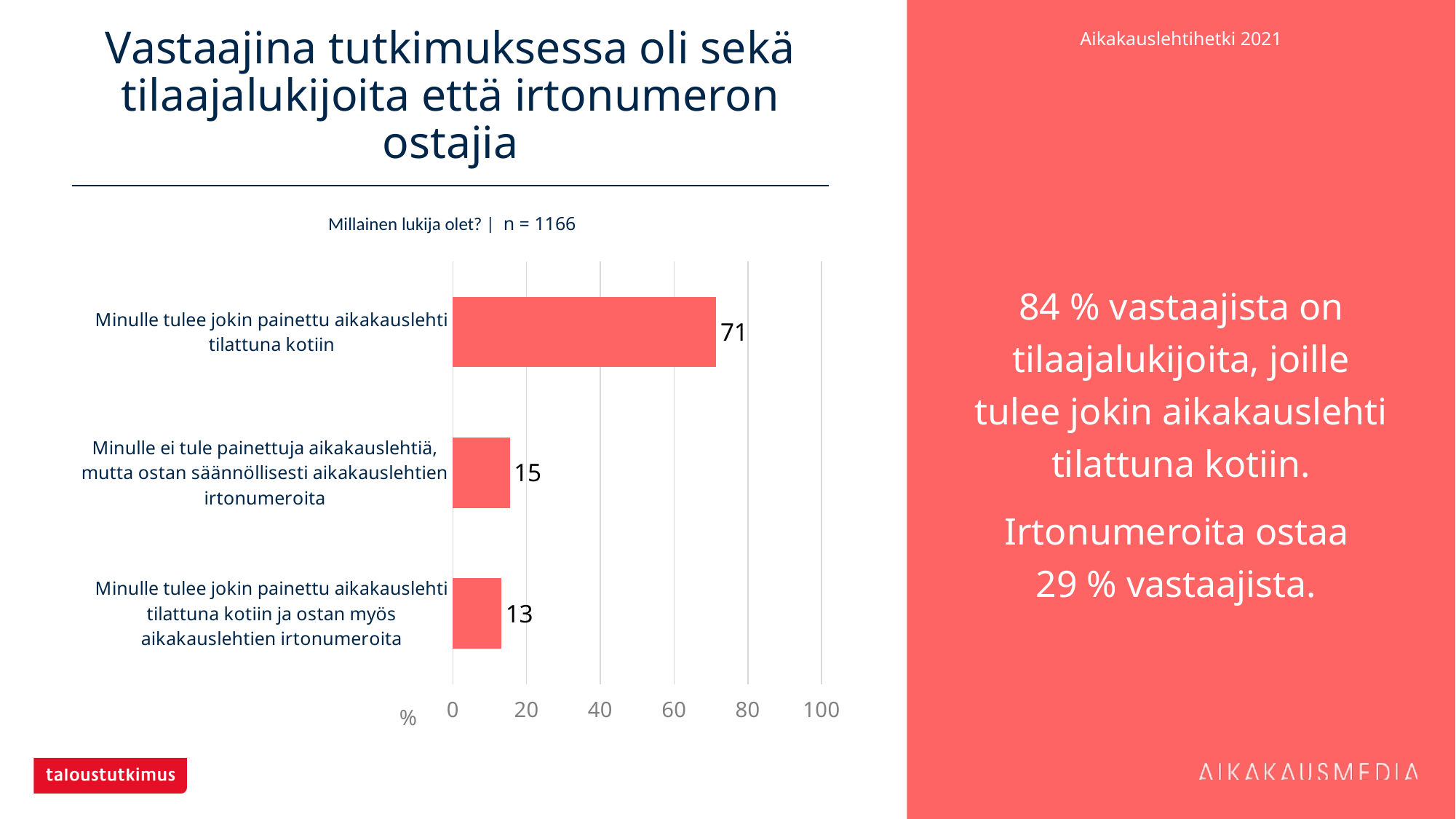
What is the value for "Minulle ei tule painettuja aikakauslehtiä, mutta ostan säännöllisesti aikakauslehtien irtonumeroita"? 15 What is the sample size (n) stated above the chart? n = 1166 What is the difference between the value for "Minulle tulee jokin painettu aikakauslehti tilattuna kotiin" and the value for "Minulle ei tule painettuja aikakauslehtiä, mutta ostan säännöllisesti aikakauslehtien irtonumeroita"? 56 Which is larger: the value for "Minulle ei tule painettuja aikakauslehtiä, mutta ostan säännöllisesti aikakauslehtien irtonumeroita" or the value for "Minulle tulee jokin painettu aikakauslehti tilattuna kotiin ja ostan myös aikakauslehtien irtonumeroita"? Minulle ei tule painettuja aikakauslehtiä, mutta ostan säännöllisesti aikakauslehtien irtonumeroita What kind of chart is shown on the slide? bar chart Which category has the highest value? Minulle tulee jokin painettu aikakauslehti tilattuna kotiin How many categories are shown in the chart? 3 What is the value for "Minulle tulee jokin painettu aikakauslehti tilattuna kotiin ja ostan myös aikakauslehtien irtonumeroita"? 13 Is the value for "Minulle tulee jokin painettu aikakauslehti tilattuna kotiin" greater or less than 60? greater Which category has the lowest value? Minulle tulee jokin painettu aikakauslehti tilattuna kotiin ja ostan myös aikakauslehtien irtonumeroita What is the difference between the value for "Minulle ei tule painettuja aikakauslehtiä, mutta ostan säännöllisesti aikakauslehtien irtonumeroita" and the value for "Minulle tulee jokin painettu aikakauslehti tilattuna kotiin ja ostan myös aikakauslehtien irtonumeroita"? 2 What is the value for "Minulle tulee jokin painettu aikakauslehti tilattuna kotiin"? 71